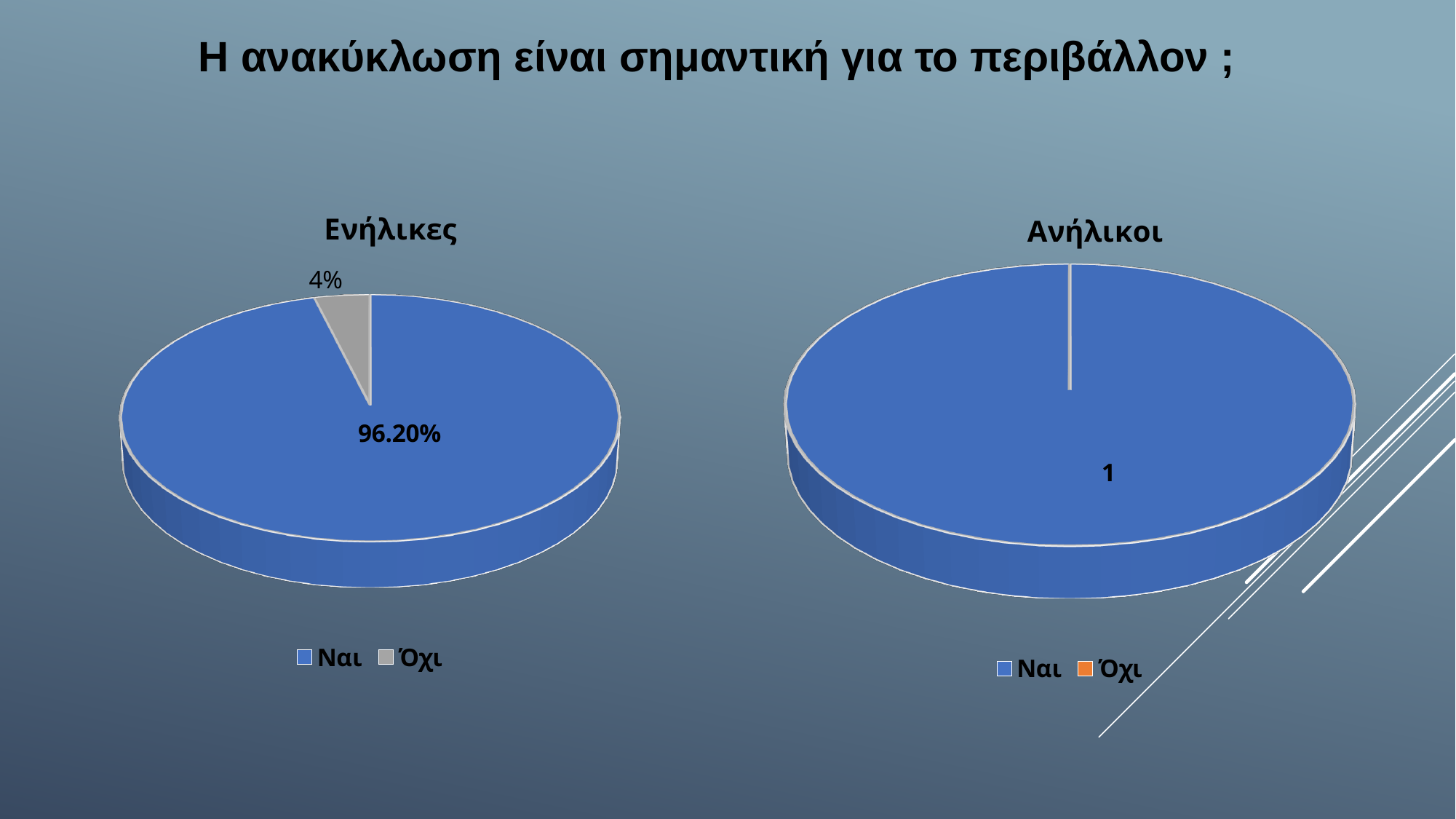
In the "Ενήλικες" chart, which is larger, Ναι or Όχι? Ναι How many categories does the legend of the "Ανήλικοι" chart list? 2 How many categories does the legend of the "Ενήλικες" chart list? 2 In the "Ενήλικες" chart, which category has the smallest slice? Όχι In the "Ενήλικες" chart, what is the value shown for Ναι? 96.20% In the "Ανήλικοι" chart, what value is printed on the Ναι slice? 1 In the "Ανήλικοι" chart, which category takes up the whole pie? Ναι In the "Ενήλικες" chart, which category has the largest slice? Ναι What is the title of the chart on the right? Ανήλικοι What kind of chart is the "Ενήλικες" chart? Pie chart What colour is the Όχι slice in the "Ενήλικες" chart? Grey In the "Ενήλικες" chart, what is the value shown for Όχι? 4%